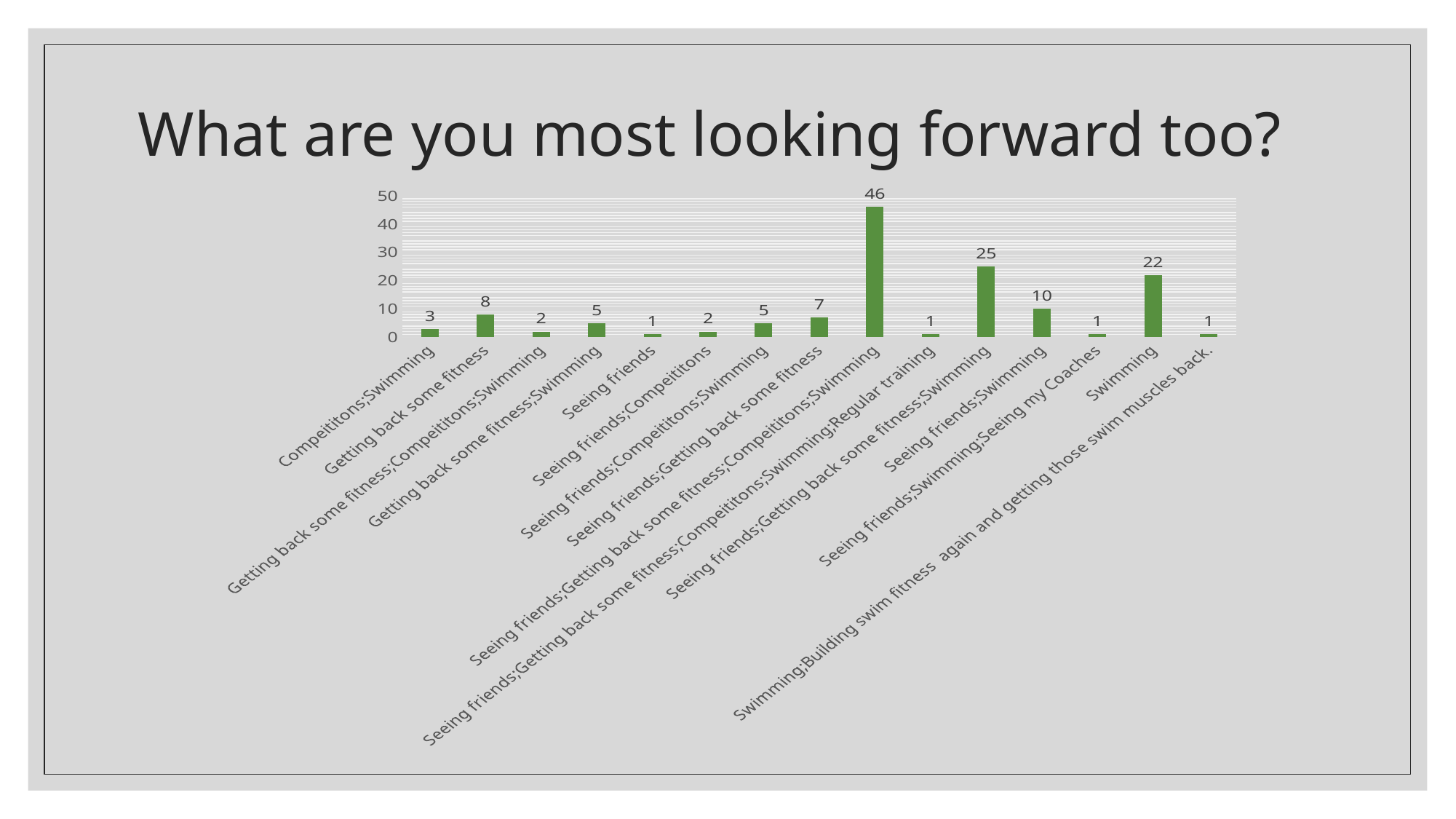
What is the value for "Getting back some fitness"? 8 What kind of chart is shown on the slide? bar chart Is the value for "Seeing friends;Getting back some fitness;Swimming" greater or less than 20? greater Which category has the highest value? Seeing friends;Getting back some fitness;Compeititons;Swimming Which is larger, the value for "Getting back some fitness" or the value for "Seeing friends;Getting back some fitness"? Getting back some fitness What is the difference between the values for "Swimming" and "Seeing friends;Swimming"? 12 What is the value for "Swimming"? 22 What is the difference between the values for "Seeing friends;Getting back some fitness;Competititons;Swimming" and "Seeing friends;Getting back some fitness;Swimming"? 21 What is the value for "Seeing friends;Getting back some fitness;Swimming"? 25 What is the highest value shown on the chart? 46 What is the value for "Seeing friends;Swimming"? 10 How many categories are shown on the chart? 15